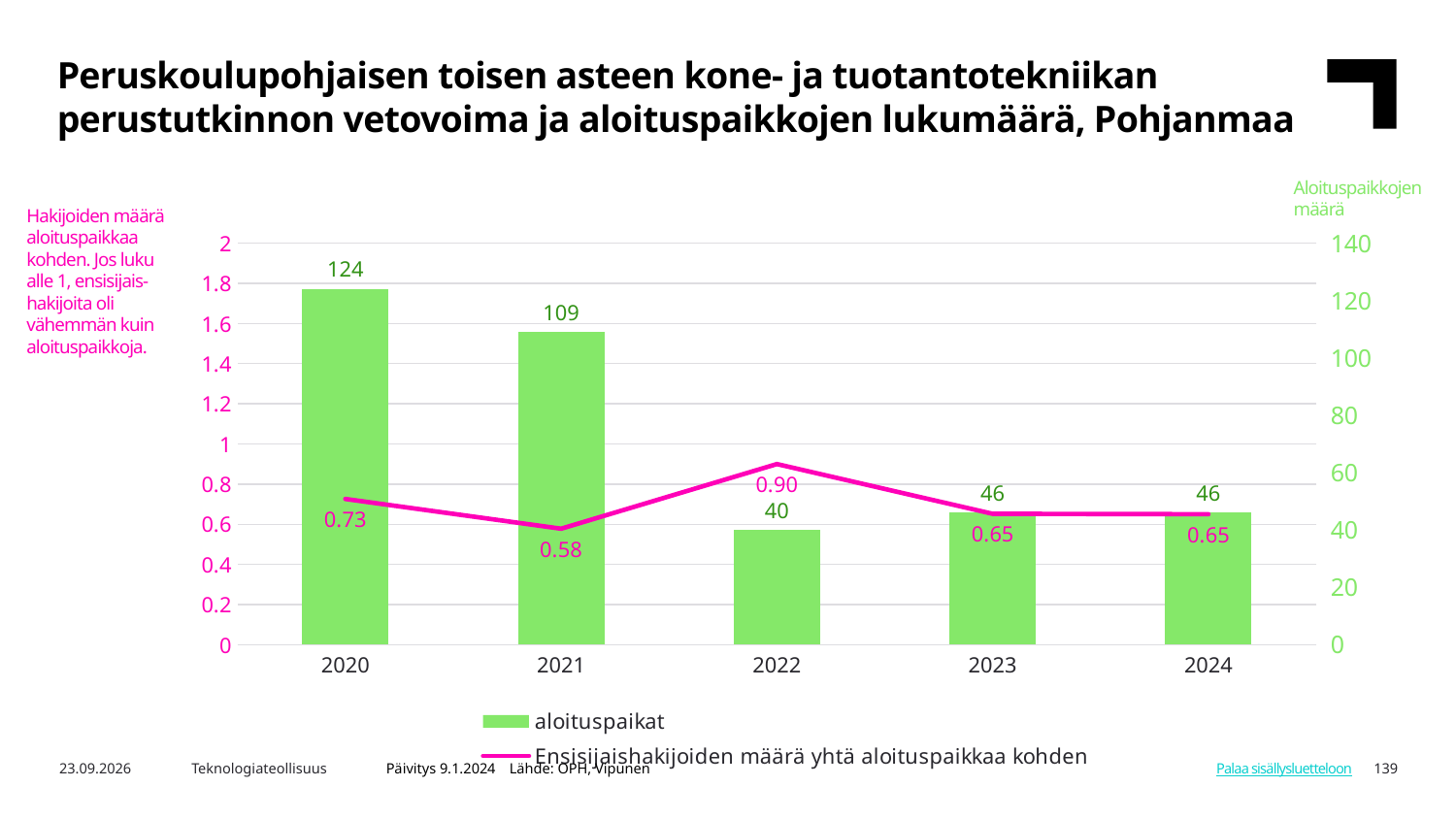
Which year has the lowest value of Ensisijaishakijoiden määrä yhtä aloituspaikkaa kohden? 2021 Which year has the lowest value of aloituspaikat? 2022 What is the value of Ensisijaishakijoiden määrä yhtä aloituspaikkaa kohden for 2022? 0.90 How many years are shown on the x axis? 5 What colour are the aloituspaikat bars? green What is the difference in aloituspaikat between 2020 and 2021? 15 How many series does the legend list? 2 Which is larger, the aloituspaikat value for 2021 or for 2023? 2021 Do the aloituspaikat values rise or fall from 2020 to 2022? fall What is the value of aloituspaikat for 2020? 124 Which year has the highest value of aloituspaikat? 2020 What is the value of aloituspaikat for 2022? 40